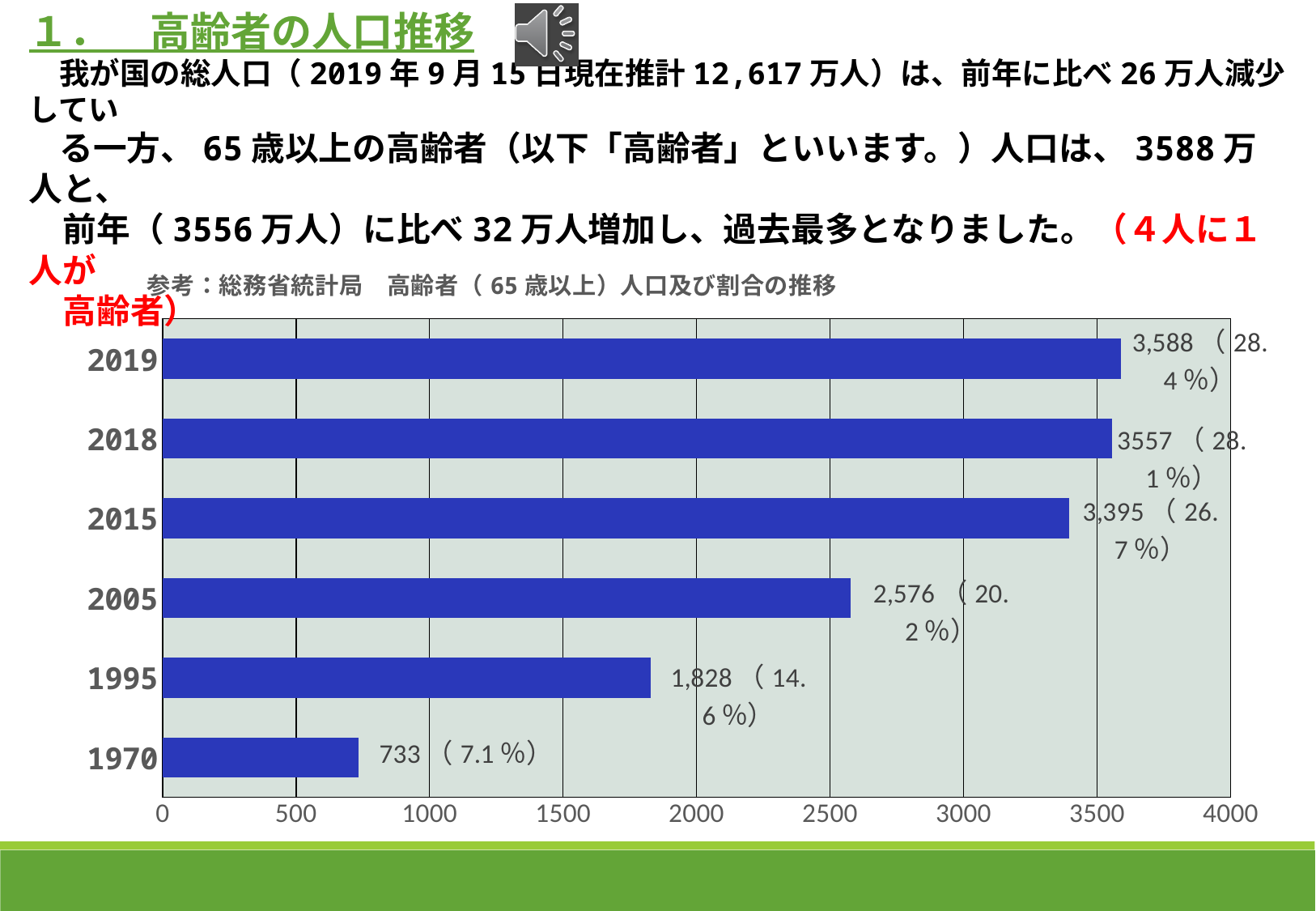
What is the difference between the values for 2015 and 2005? 819 What is the value shown for 2005? 2,576 Which year has the highest value in the chart? 2019 What is the maximum value shown on the horizontal axis of the chart? 4000 What is the difference between the values for 1995 and 1970? 1,095 What is the value shown for 2019 in the bar chart? 3,588 Which year has the lowest value in the chart? 1970 What type of chart is shown on the slide? Bar chart Which is larger, the value for 2005 or the value for 1995? 2005 How many years (categories) are shown in the bar chart? 6 What is the value shown for 1970? 733 What percentage is shown in parentheses next to the 2015 bar? 26.7%